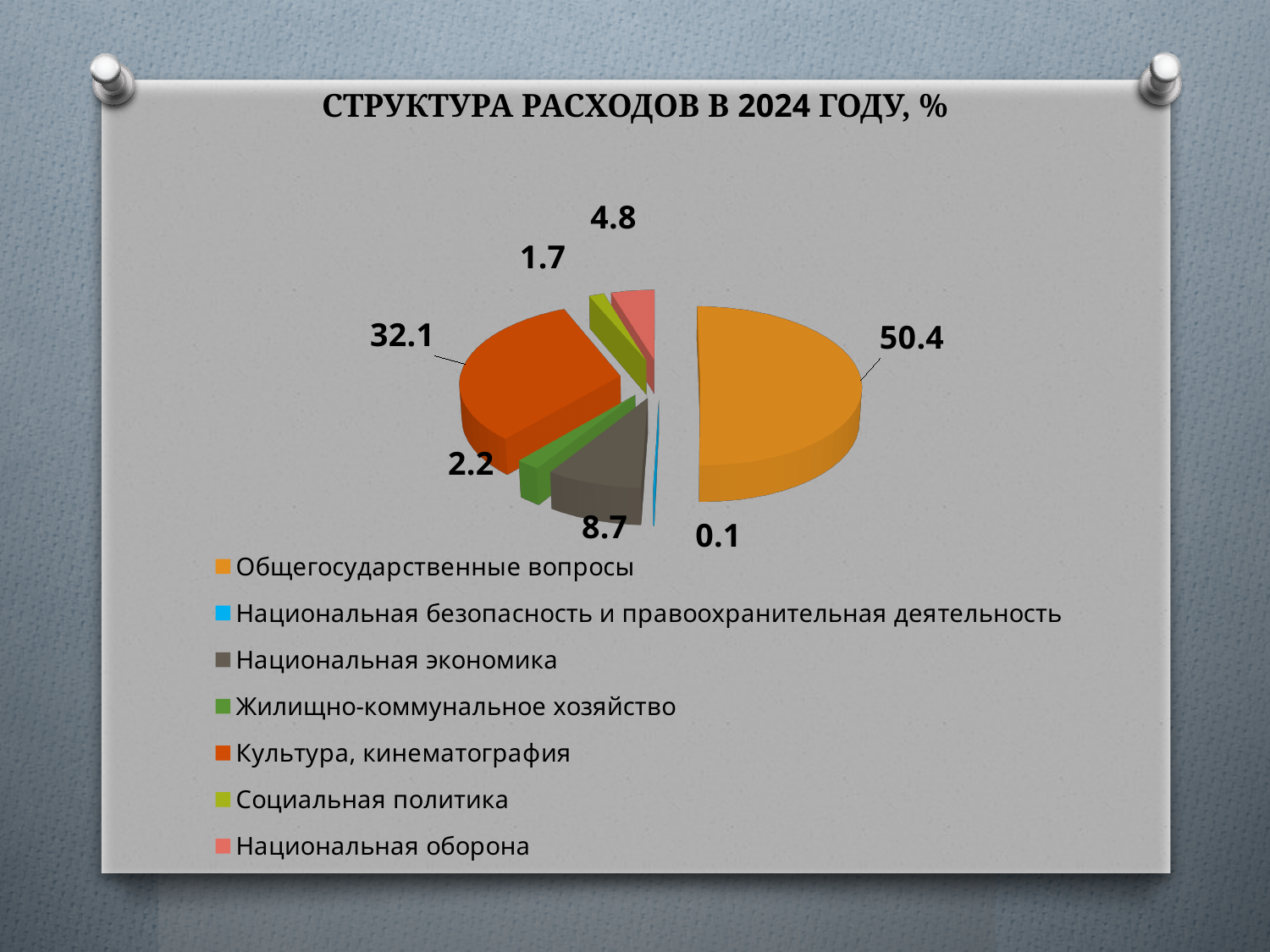
What is the title of the chart? СТРУКТУРА РАСХОДОВ В 2024 ГОДУ, % What is the difference between the values for Общегосударственные вопросы and Культура, кинематография? 18.3 Which category has the smallest share of the pie? Национальная безопасность и правоохранительная деятельность What type of chart is shown on the slide? pie chart What is the value for Национальная безопасность и правоохранительная деятельность? 0.1 What is the value for Национальная оборона? 4.8 What is the value for Национальная экономика? 8.7 Which is larger: Жилищно-коммунальное хозяйство or Социальная политика? Жилищно-коммунальное хозяйство How many categories does the legend list? 7 Which category has the largest share of the pie? Общегосударственные вопросы What is the value for Культура, кинематография? 32.1 What is the value for Общегосударственные вопросы? 50.4